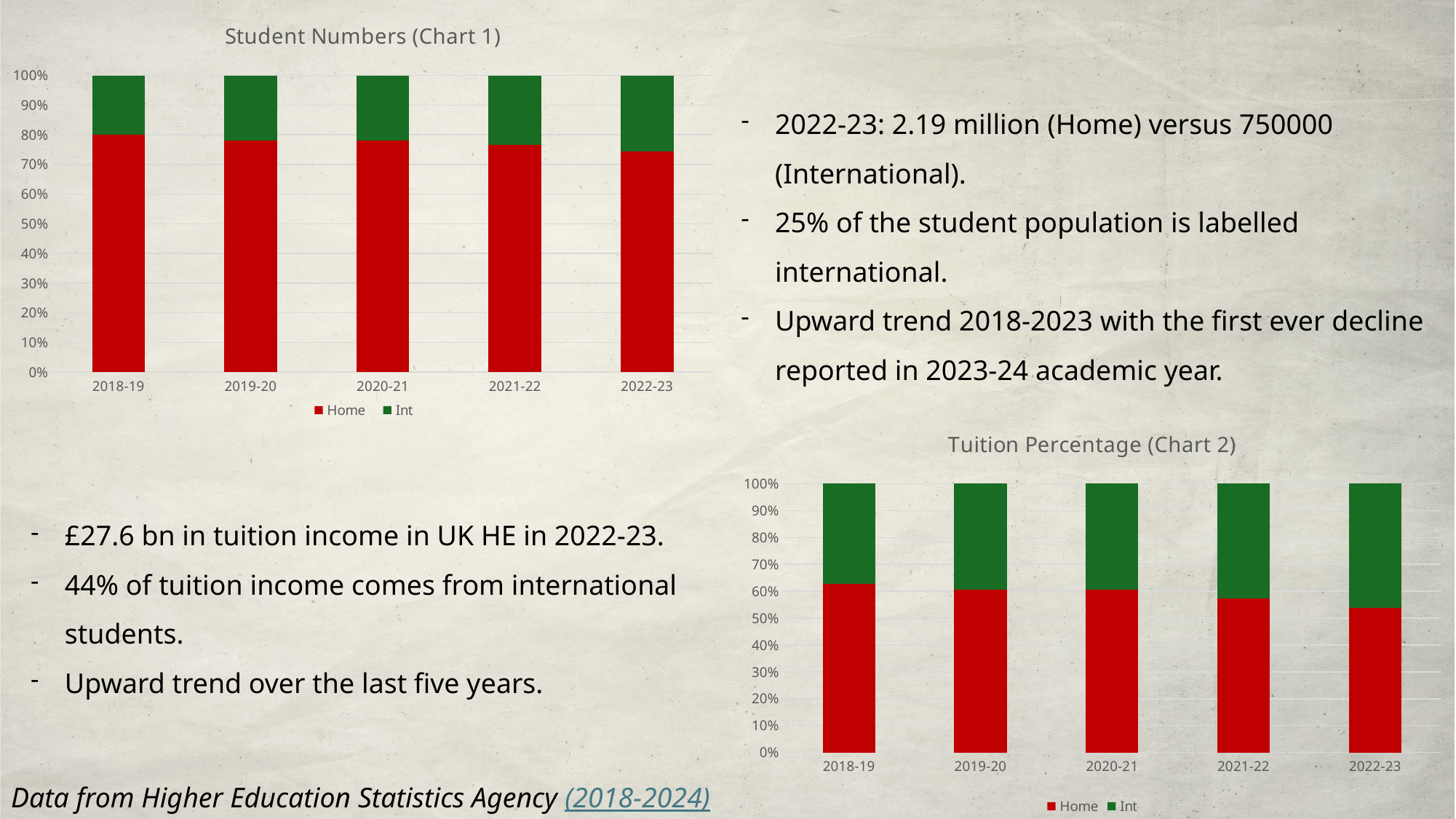
In Tuition Percentage (Chart 2), which year has the lowest Home share? 2022-23 In Tuition Percentage (Chart 2), does the Home share rise or fall from 2018-19 to 2022-23? Fall How many academic years are shown on the x axis of Tuition Percentage (Chart 2)? 5 In Tuition Percentage (Chart 2), is the Int share for 2022-23 greater or less than 40%? greater How many series does the legend of Student Numbers (Chart 1) list? 2 In Tuition Percentage (Chart 2), is the Home share for 2022-23 greater or less than 60%? less Which colour represents the Int series in Student Numbers (Chart 1)? Green In Tuition Percentage (Chart 2), is the Home share for 2018-19 greater or less than 60%? greater What kind of chart is Student Numbers (Chart 1)? Stacked bar chart In Tuition Percentage (Chart 2), is the Home share larger in 2018-19 or in 2022-23? 2018-19